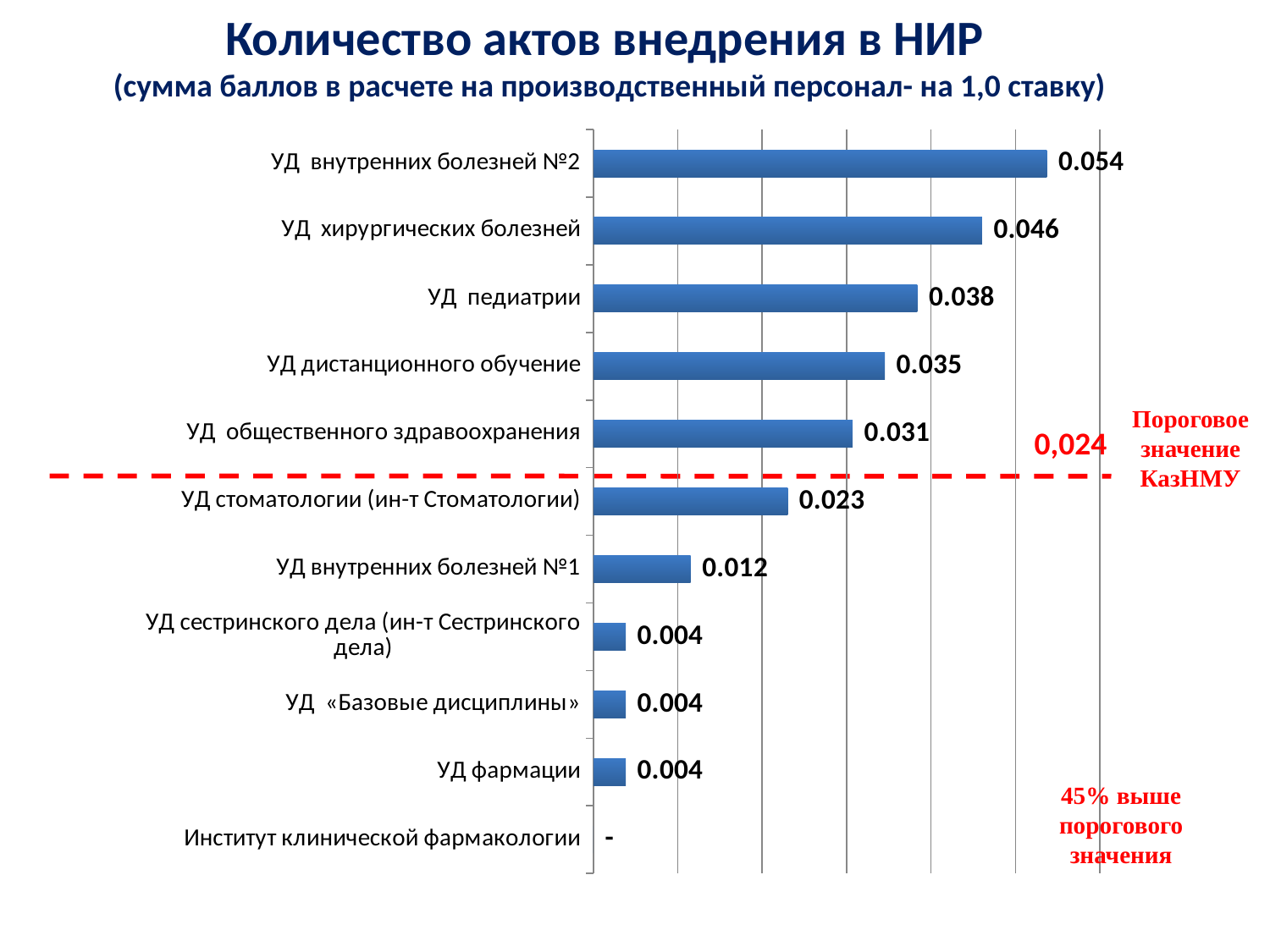
What is the threshold value (Пороговое значение КазНМУ) marked by the red dashed line? 0,024 How many categories are shown on the chart? 11 What is the value for УД педиатрии? 0.038 Which is larger, the value for УД дистанционного обучение or the value for УД общественного здравоохранения? УД дистанционного обучение What is the value for УД стоматологии (ин-т Стоматологии)? 0.023 What value is shown for Институт клинической фармакологии? - What kind of chart is shown on the slide? Bar chart What is the value for УД внутренних болезней №2? 0.054 Do the bar values increase or decrease from the top of the chart to the bottom? Decrease What is the difference between the values for УД внутренних болезней №2 and УД хирургических болезней? 0.008 What is the value for УД внутренних болезней №1? 0.012 Which category has the highest value? УД внутренних болезней №2